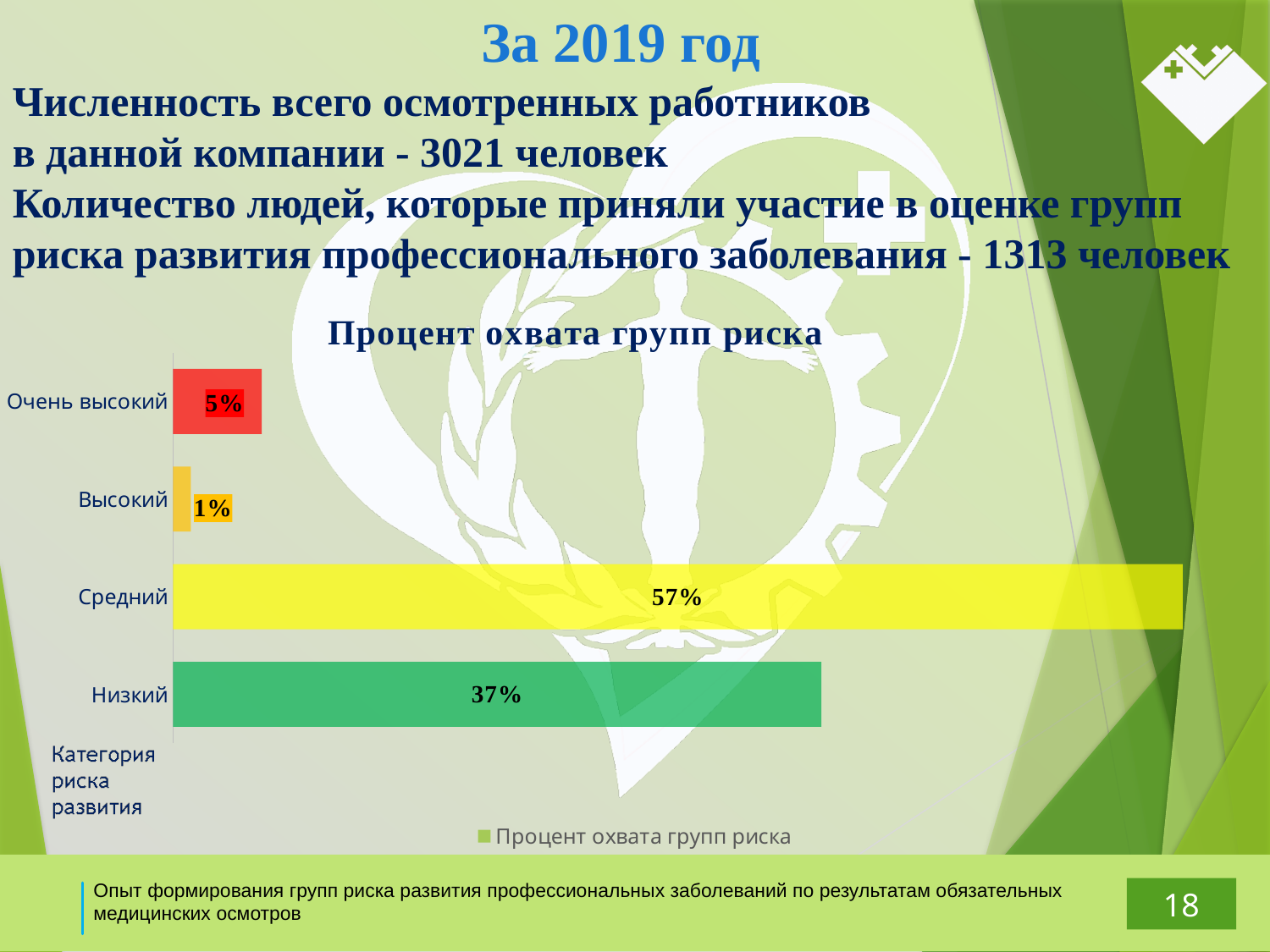
What kind of chart is shown on the slide? Bar chart What is the difference between the values for 'Средний' and 'Низкий'? 20% How many categories are shown in the chart? 4 What is the value for the 'Высокий' category? 1% Which category has the highest value? Средний What is the title of the chart? Процент охвата групп риска Which category has the lowest value? Высокий What is the value for the 'Средний' category? 57% What is the value for the 'Очень высокий' category? 5% How many series does the legend list? 1 Which is larger, the value for 'Очень высокий' or the value for 'Высокий'? Очень высокий What is the value for the 'Низкий' category? 37%